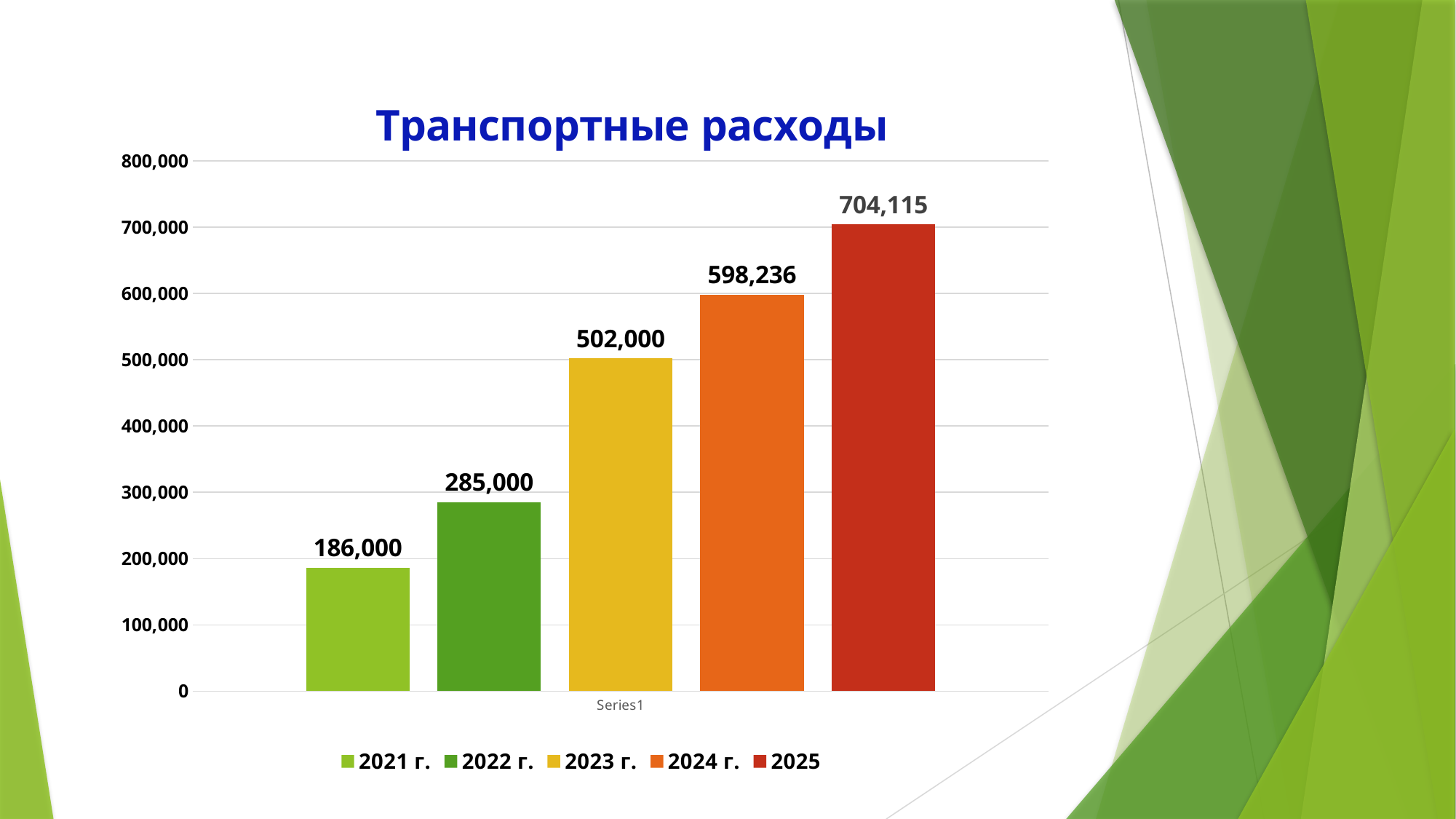
What kind of chart is shown on the slide? bar chart How many series does the legend list? 5 Is the value for 2025 greater or less than 700,000? greater What is the title of the chart? Транспортные расходы What is the value for 2023 г.? 502,000 What is the value for 2021 г.? 186,000 What is the difference between the values for 2022 г. and 2021 г.? 99,000 What is the difference between the values for 2024 г. and 2023 г.? 96,236 Which year has the lowest value? 2021 г. What is the value for 2025? 704,115 Which year has the highest value? 2025 Which is larger, the value for 2022 г. or the value for 2024 г.? 2024 г.